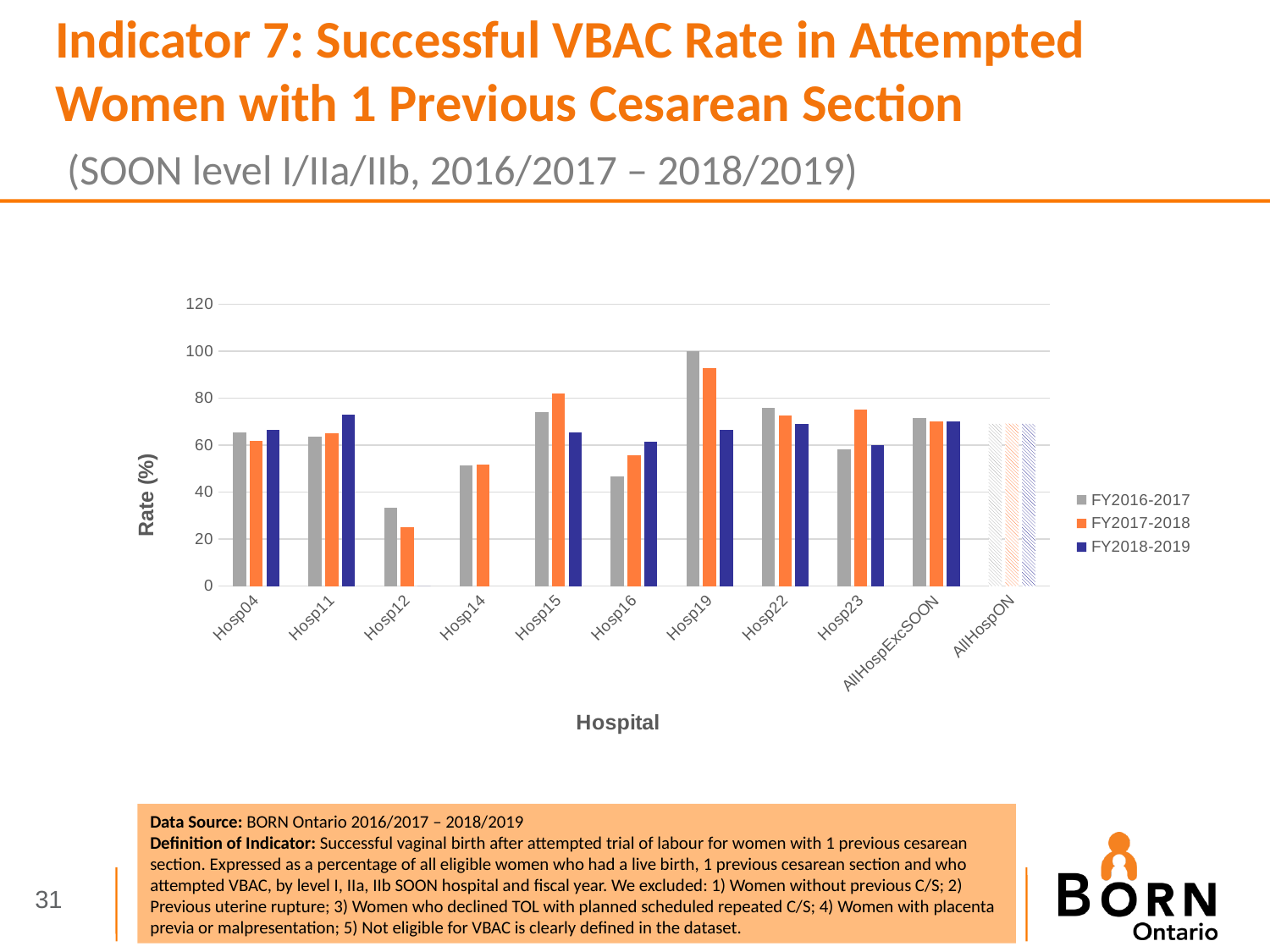
Which hospital has the lowest FY2017-2018 value? Hosp12 What kind of chart is shown on the slide? bar chart Which hospital has the highest FY2016-2017 value? Hosp19 Is the FY2016-2017 value for Hosp16 greater or less than 60? less How many series does the legend list? 3 What is the FY2016-2017 value for Hosp19? 100 For Hosp19, which is larger: the FY2016-2017 value or the FY2018-2019 value? FY2016-2017 How many hospital categories are shown on the x axis? 11 What is the title of the y axis? Rate (%) Is the FY2017-2018 value for Hosp12 greater or less than 40? less For Hosp12, which is larger: the FY2016-2017 value or the FY2017-2018 value? FY2016-2017 Is the FY2017-2018 value for Hosp19 greater or less than 80? greater